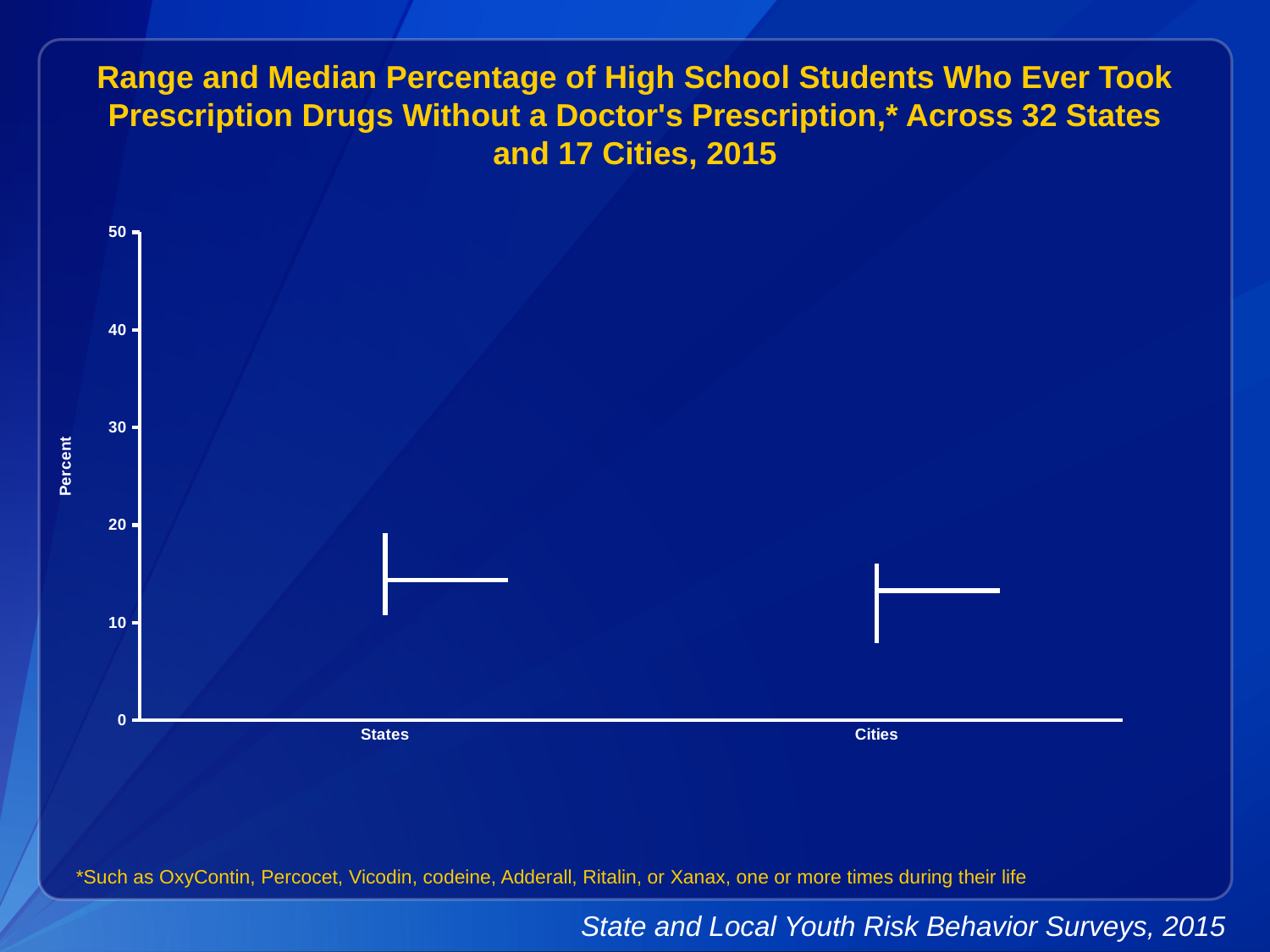
Is the median value for Cities greater or less than 20? less Is the lowest value in the range for Cities greater or less than 10? less What is the highest value shown on the y axis of the chart? 50 What is the label on the y axis of the chart? Percent How many categories are shown on the x axis of the chart? 2 Which year does the chart's data refer to, according to the title? 2015 What are the two categories shown on the x axis? States and Cities